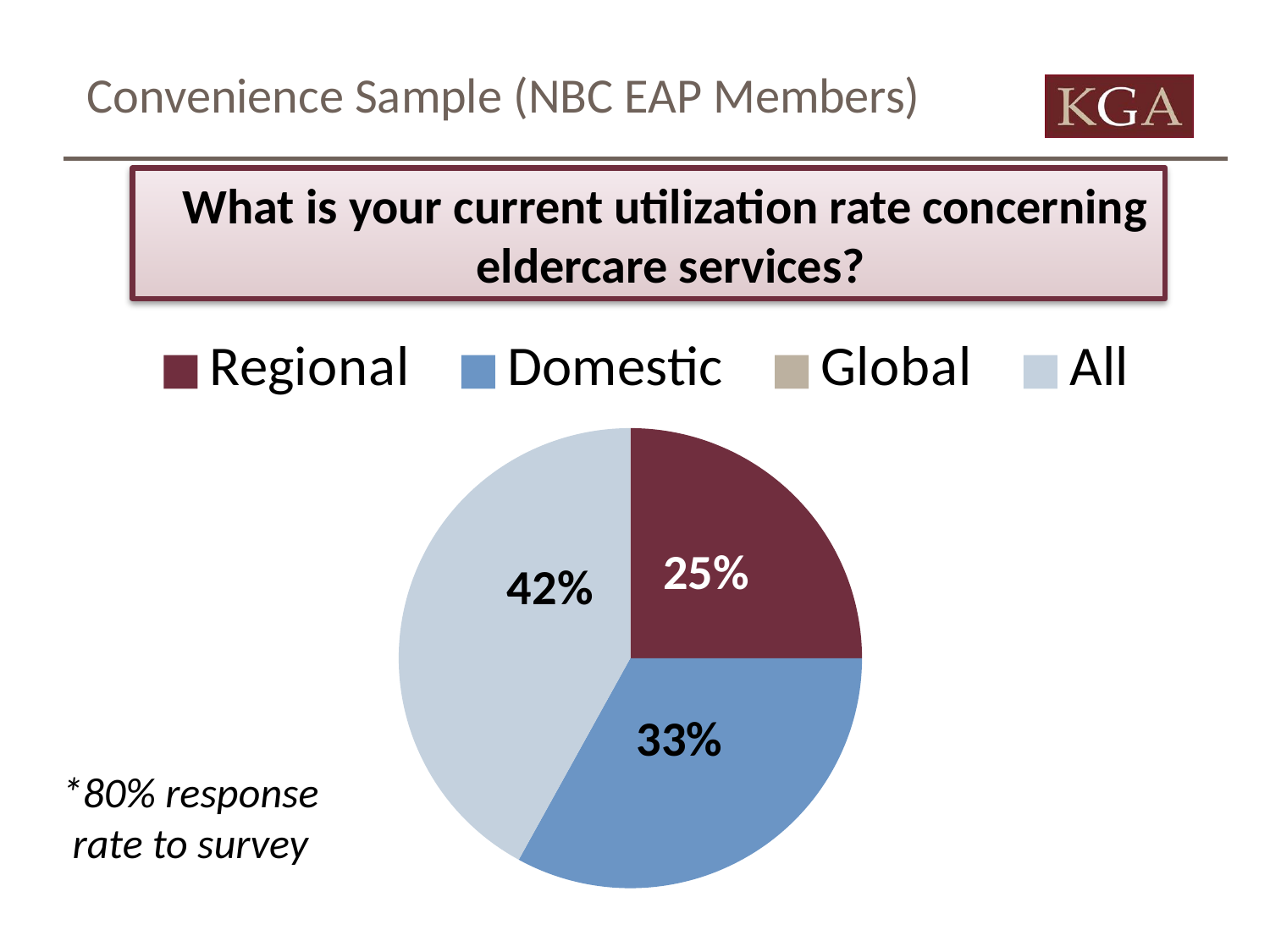
Which labeled slice of the pie is the smallest? Regional Which labeled slice of the pie is the largest? All What colour is the Regional slice in the pie chart? dark red What percentage of the pie is the Regional slice? 25% What is the difference in percentage points between the Domestic slice and the Regional slice? 8 What is the difference in percentage points between the All slice and the Regional slice? 17 What percentage of the pie is the Domestic slice? 33% What percentage of the pie is the All slice? 42% How many entries does the legend list? 4 How many slices have a percentage label printed on the pie? 3 What type of chart is shown on the slide? pie chart Which slice is larger, Domestic or Regional? Domestic